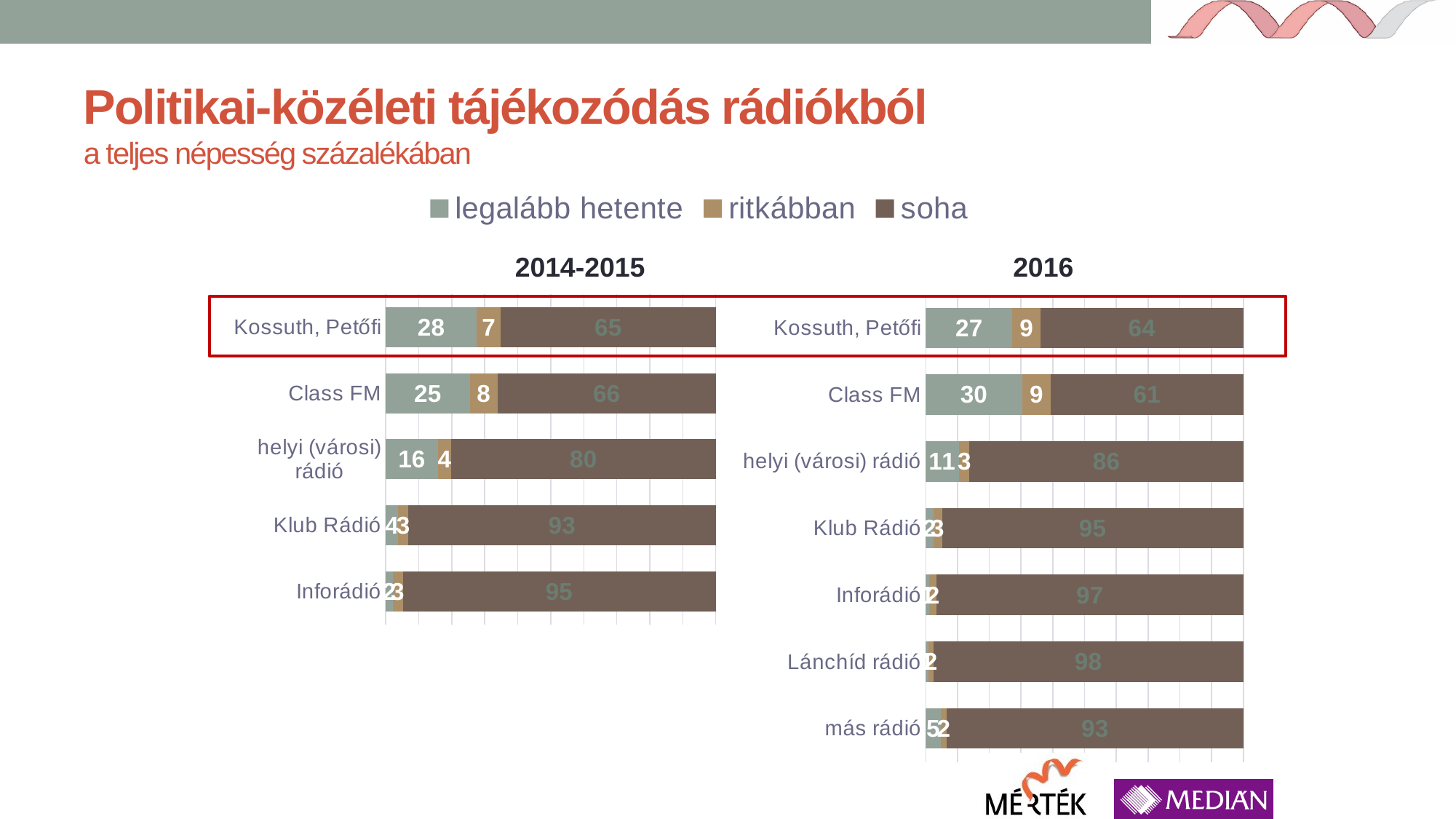
In the 2014-2015 chart, what is the 'legalább hetente' value for Kossuth, Petőfi? 28 In the 2016 chart, which station has the lowest 'soha' value? Class FM In the 2016 chart, what is the 'soha' value for Class FM? 61 What kind of chart is used for the 2014-2015 data? Stacked bar chart How many series does the legend list? 3 How many stations are listed in the 2016 chart? 7 In the 2014-2015 chart, which station has the highest 'soha' value? Inforádió In the 2016 chart, which has the larger 'legalább hetente' value, Kossuth, Petőfi or Class FM? Class FM How many stations are listed in the 2014-2015 chart? 5 What is the difference between the 'soha' value for helyi (városi) rádió in the 2016 chart and in the 2014-2015 chart? 6 In the 2016 chart, what is the 'soha' value for Lánchíd rádió? 98 In the 2016 chart, what is the 'legalább hetente' value for Class FM? 30